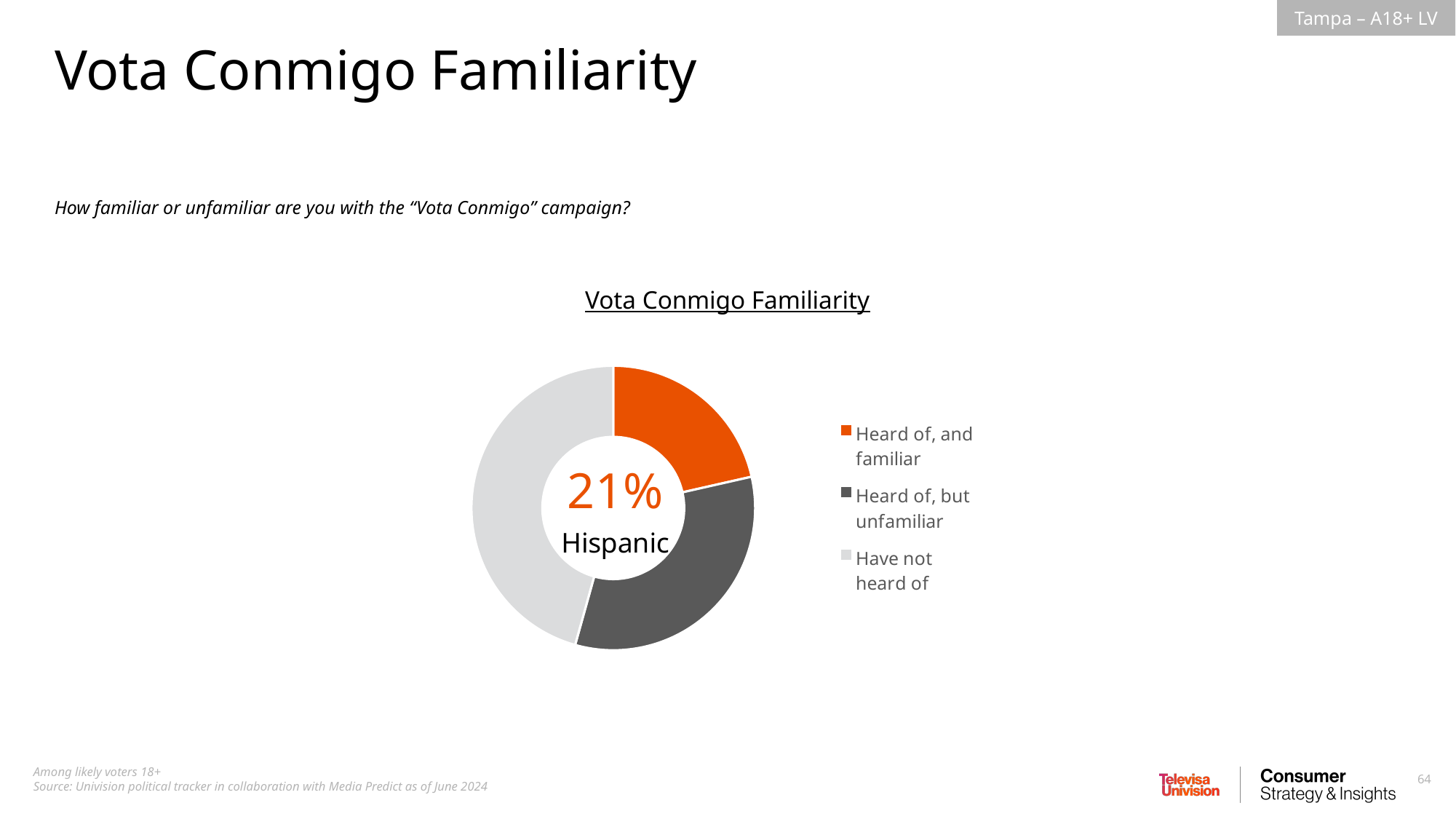
What percentage is printed in the centre of the donut chart? 21% Which category is shown in orange in the donut chart? Heard of, and familiar Which group label appears in the centre of the donut chart below the percentage? Hispanic What is the title of the chart? Vota Conmigo Familiarity Which category takes up the smallest share of the donut chart? Heard of, and familiar Which category takes up the largest share of the donut chart? Have not heard of Which is larger in the donut chart: the share for "Have not heard of" or the share for "Heard of, but unfamiliar"? Have not heard of What kind of chart is shown on the slide? Donut (pie) chart How many categories does the donut chart's legend list? 3 Which is larger in the donut chart: the share for "Heard of, but unfamiliar" or the share for "Heard of, and familiar"? Heard of, but unfamiliar